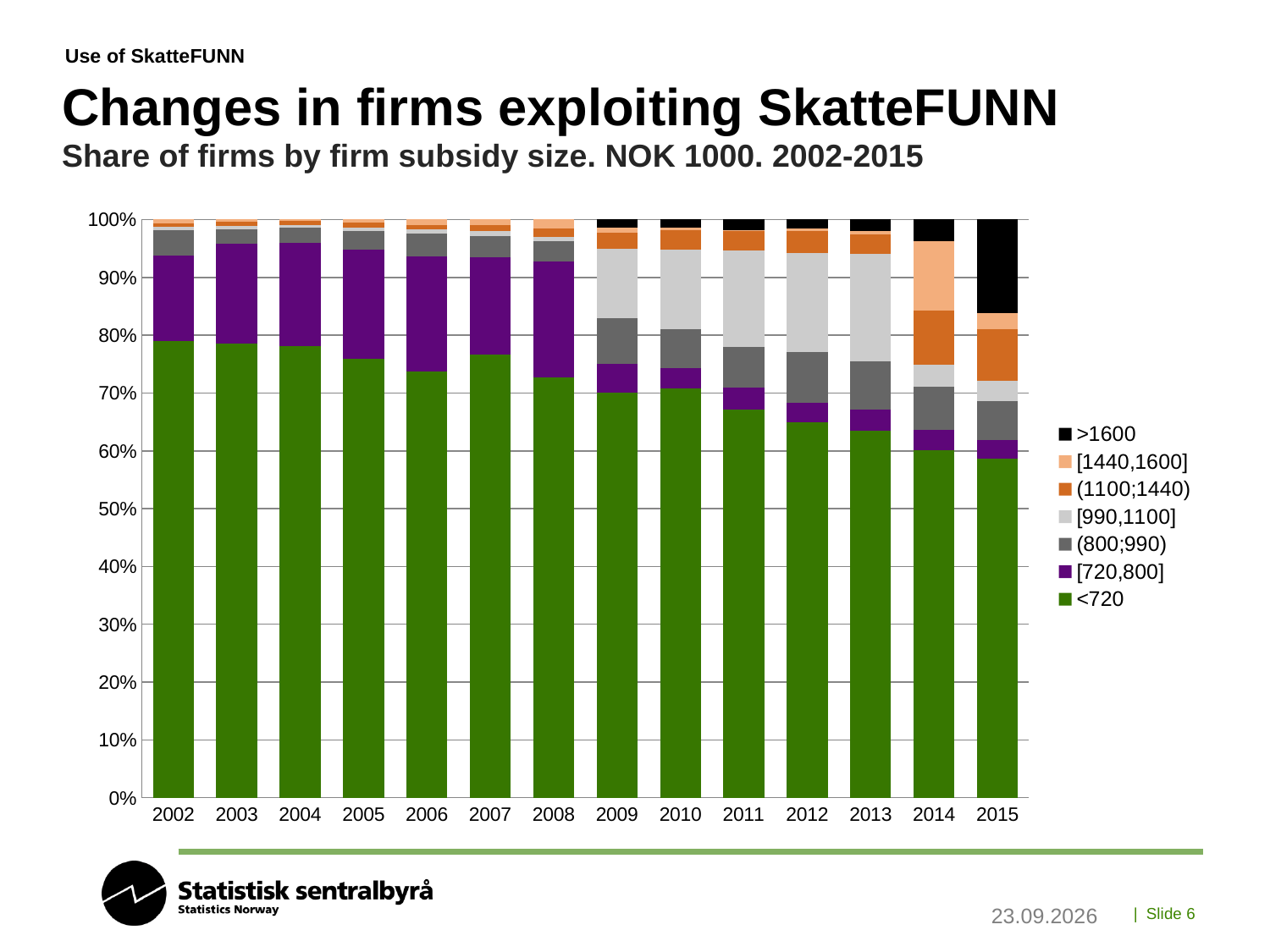
What does each stacked bar in the chart total? 100% Is the share of firms with subsidy >1600 in 2015 greater or less than 10%? greater Is the share of firms with subsidy <720 in 2002 greater or less than 70%? greater Does the share of firms with subsidy <720 rise or fall from 2002 to 2015? Fall Which is larger, the share of firms with subsidy <720 in 2002 or in 2015? 2002 What is the subtitle of the chart on the slide? Share of firms by firm subsidy size. NOK 1000. 2002-2015 What kind of chart is shown on the slide? Stacked bar chart Which subsidy-size category has the largest share in every year shown? <720 How many years are shown along the x axis of the chart? 14 Is the share of firms with subsidy <720 in 2015 greater or less than 70%? less Which year has the largest share of firms with subsidy >1600? 2015 How many series does the chart's legend list? 7